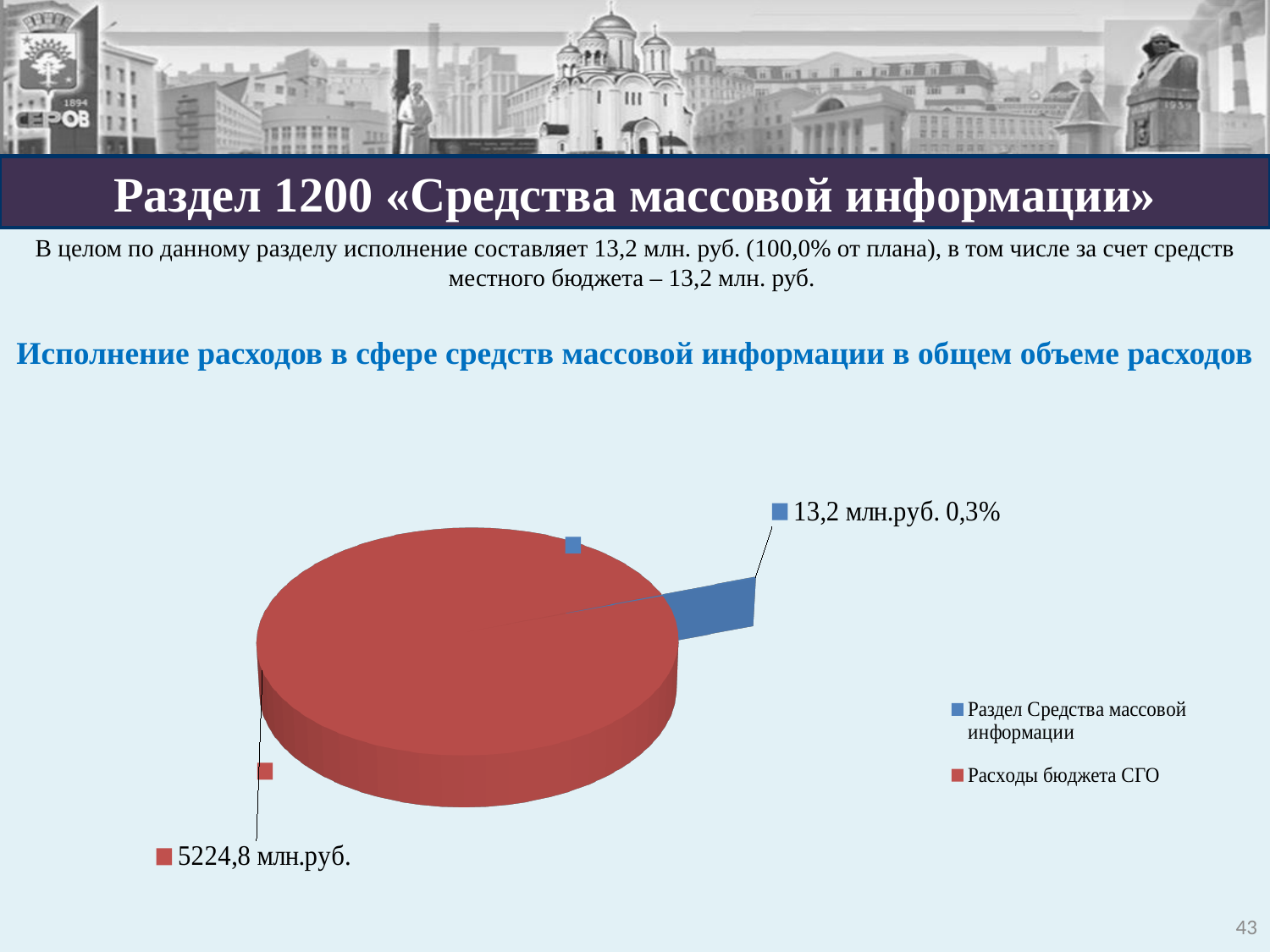
What is the title of the chart? Исполнение расходов в сфере средств массовой информации в общем объеме расходов What is the difference between the value for "Расходы бюджета СГО" and the value for "Раздел Средства массовой информации"? 5211,6 млн.руб. What kind of chart is shown on the slide? Pie chart What value is shown for the slice "Раздел Средства массовой информации"? 13,2 млн.руб. Which slice of the pie is the largest? Расходы бюджета СГО Which is larger: "Расходы бюджета СГО" or "Раздел Средства массовой информации"? Расходы бюджета СГО How many entries does the legend list? 2 Which slice of the pie is the smallest? Раздел Средства массовой информации What value is shown for the slice "Расходы бюджета СГО"? 5224,8 млн.руб. What colour is the slice for "Расходы бюджета СГО"? Red How many slices does the pie chart have? 2 What share of the pie does "Раздел Средства массовой информации" represent? 0,3%